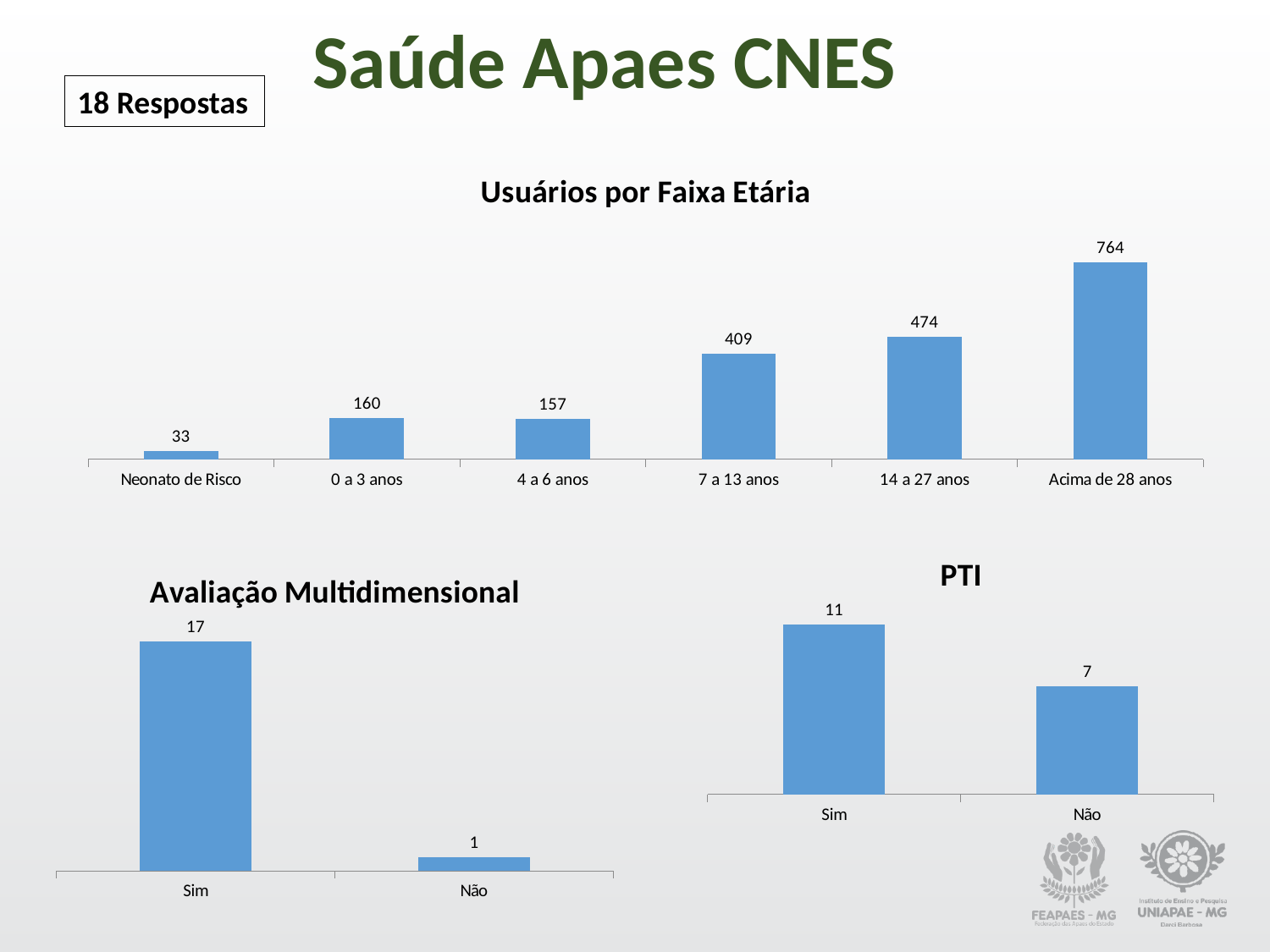
In the 'Avaliação Multidimensional' chart, what is the value for 'Sim'? 17 In the 'PTI' chart, what is the value for 'Não'? 7 In the 'Avaliação Multidimensional' chart, what is the difference between 'Sim' and 'Não'? 16 In the 'Usuários por Faixa Etária' chart, what is the difference between 'Acima de 28 anos' and '14 a 27 anos'? 290 In the 'Usuários por Faixa Etária' chart, which category has the highest value? Acima de 28 anos In the 'Usuários por Faixa Etária' chart, which is larger: '0 a 3 anos' or '4 a 6 anos'? 0 a 3 anos What is the title of the chart at the top of the slide? Usuários por Faixa Etária In the 'Usuários por Faixa Etária' chart, what is the value for '7 a 13 anos'? 409 In the 'Usuários por Faixa Etária' chart, which category has the lowest value? Neonato de Risco What kind of chart is 'Usuários por Faixa Etária'? Bar chart In the 'PTI' chart, which category has the higher value? Sim How many categories are shown in the 'Usuários por Faixa Etária' chart? 6